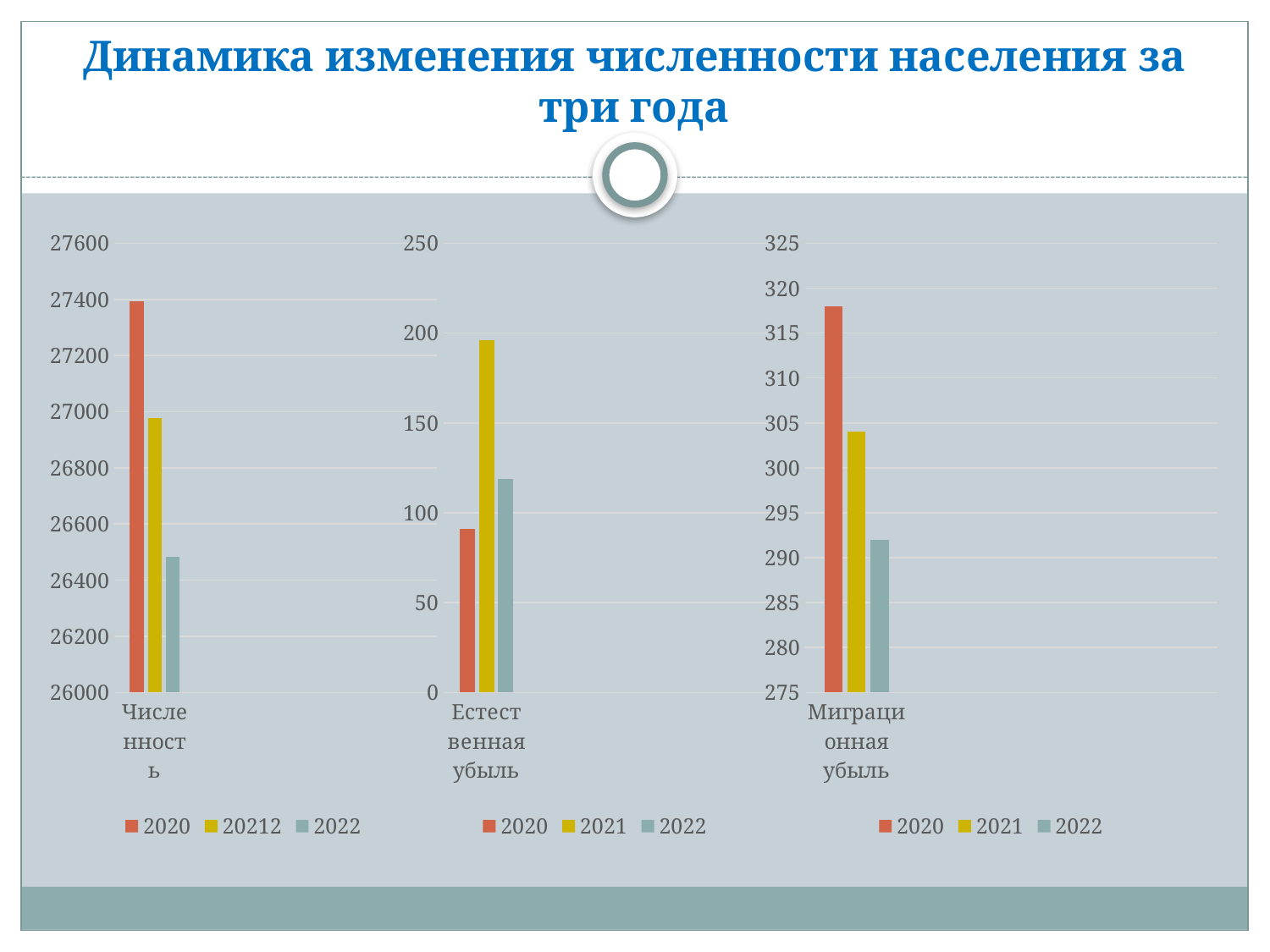
What kind of chart is the left chart (Численность)? bar chart In the right chart (Миграционная убыль), is the value for 2020 greater or less than 315? greater In the right chart (Миграционная убыль), which year has the lowest value? 2022 How many charts are shown on the slide? 3 In the left chart (Численность), which year has the lowest value? 2022 In the middle chart (Естественная убыль), which year has the highest value? 2021 In the left chart (Численность), do the values rise or fall from 2020 to 2022? fall In the middle chart (Естественная убыль), is the value for 2020 greater or less than 100? less In the left chart (Численность), which year has the highest value? 2020 In the left chart (Численность), how many series does the legend list? 3 In the left chart (Численность), is the value for 2022 greater or less than 26600? less In the middle chart (Естественная убыль), which is larger, the value for 2022 or the value for 2020? 2022